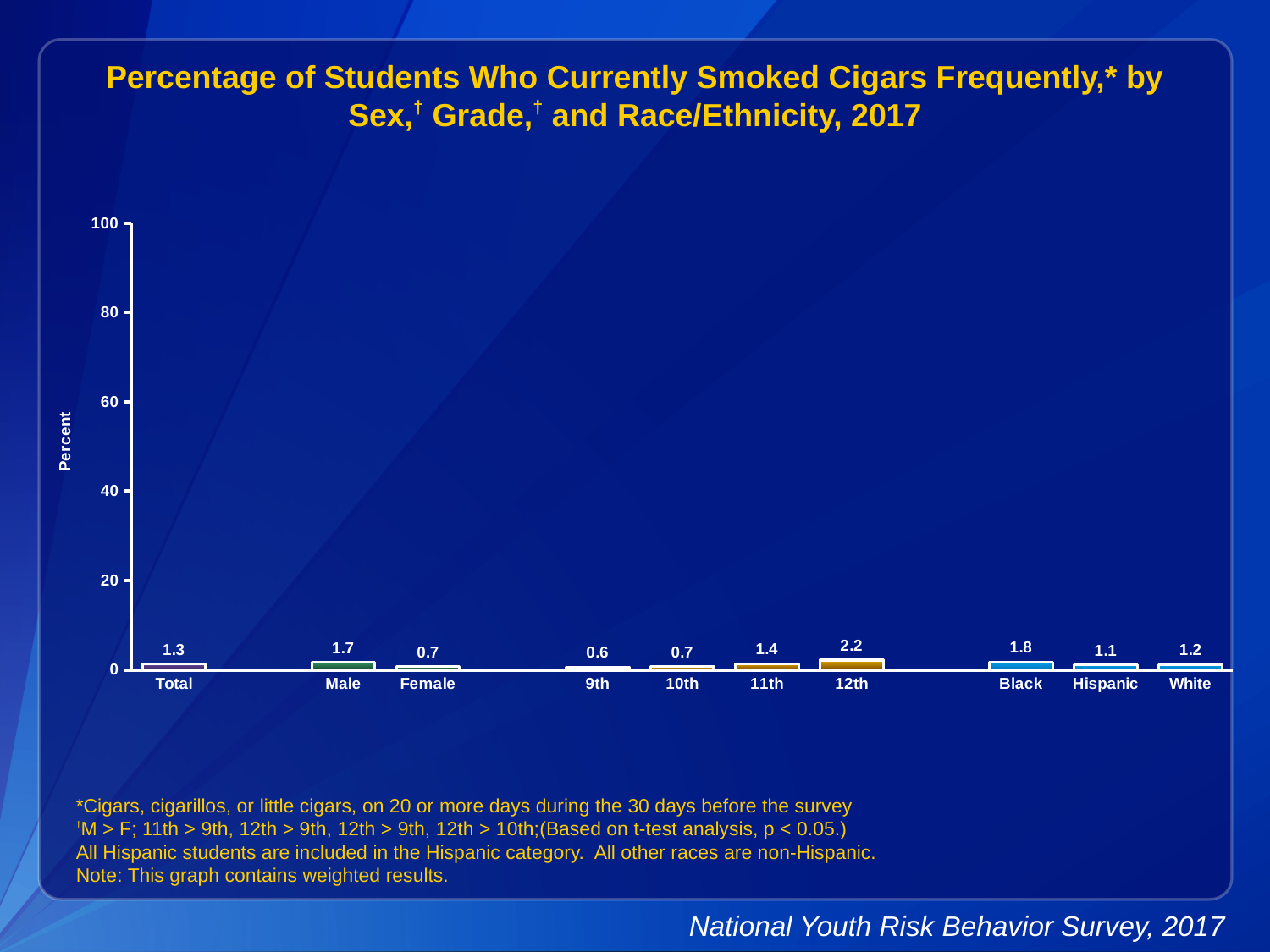
Which is larger, the value for Black or the value for White? Black What kind of chart is this? bar chart What is the label of the y axis? Percent What is the value for 12th grade? 2.2 Which category has the highest value? 12th What percentage of male students currently smoked cigars frequently? 1.7 Is the value for 12th grade greater or less than 20? less What is the value for Total? 1.3 How many categories are shown on the x axis? 10 What is the value for Hispanic students? 1.1 Which category has the lowest value? 9th What is the difference between the Male and Female values? 1.0